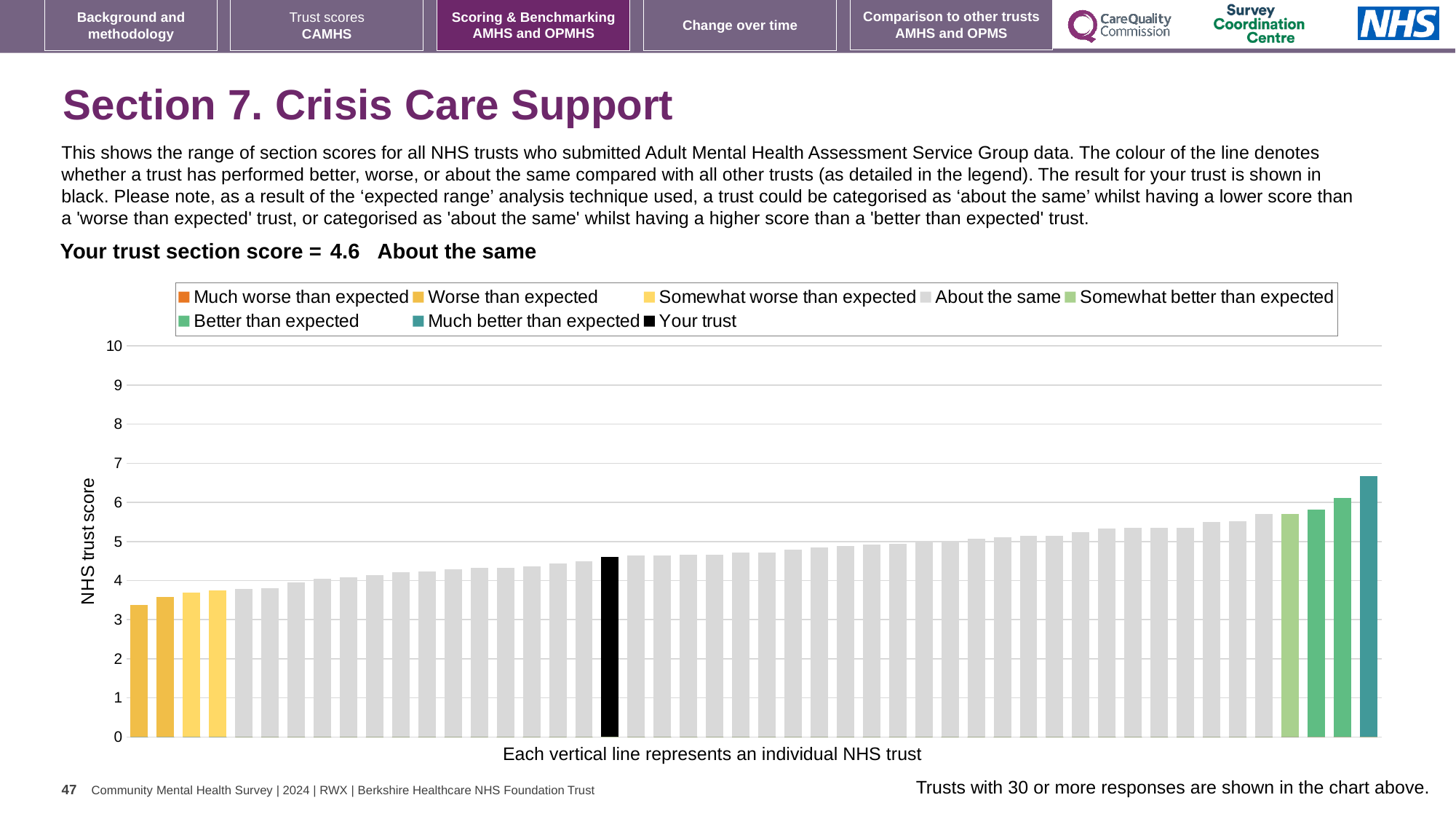
Which category is your trust's section score placed in? About the same Which legend category does the tallest bar in the chart belong to? Much better than expected What kind of chart is shown on the slide? bar chart What colour is used for the 'Your trust' bar in the chart? black What is the label on the vertical axis of the chart? NHS trust score Is the value of the black 'Your trust' bar greater or less than 4? greater How many entries does the chart legend list? 8 What is the section score for your trust shown on the slide? 4.6 Is the value of the tallest bar in the chart greater or less than 6? greater Is the value of the shortest bar in the chart greater or less than 4? less Do the bar values rise or fall from left to right across the chart? rise Which legend category does the shortest bar in the chart belong to? Worse than expected